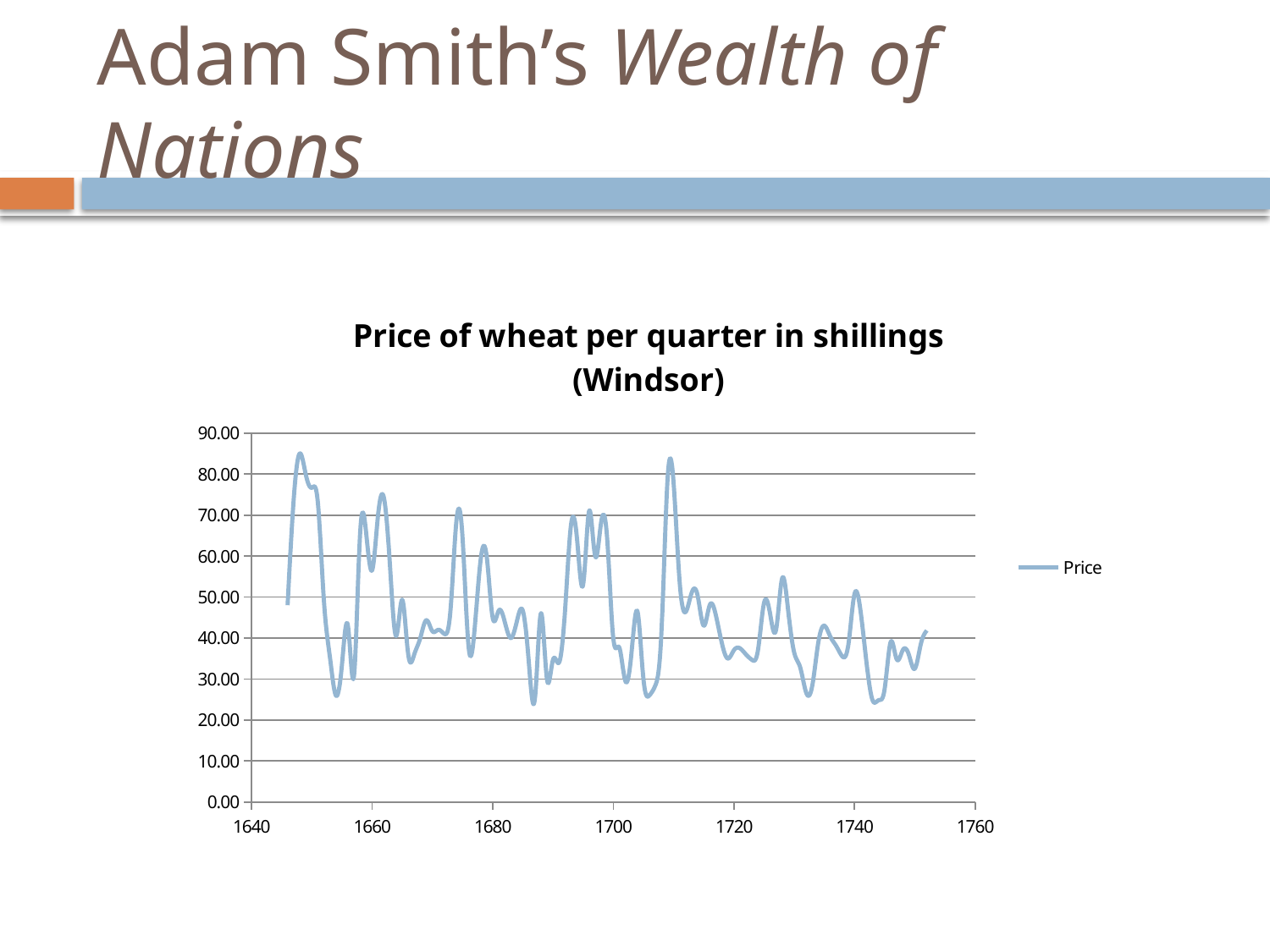
Is the price around 1732 greater or less than 30? less Is the price at its low point around 1743 greater or less than 30? less Between 1743 and 1752, does the price generally rise or fall? rise Is the peak price reached around 1648 greater or less than 80? greater Between 1709 and 1712, does the price rise or fall? fall How many series does the legend list? 1 What is the name of the series shown in the legend? Price What is the title of the chart? Price of wheat per quarter in shillings (Windsor) What kind of chart is shown on the slide? line chart